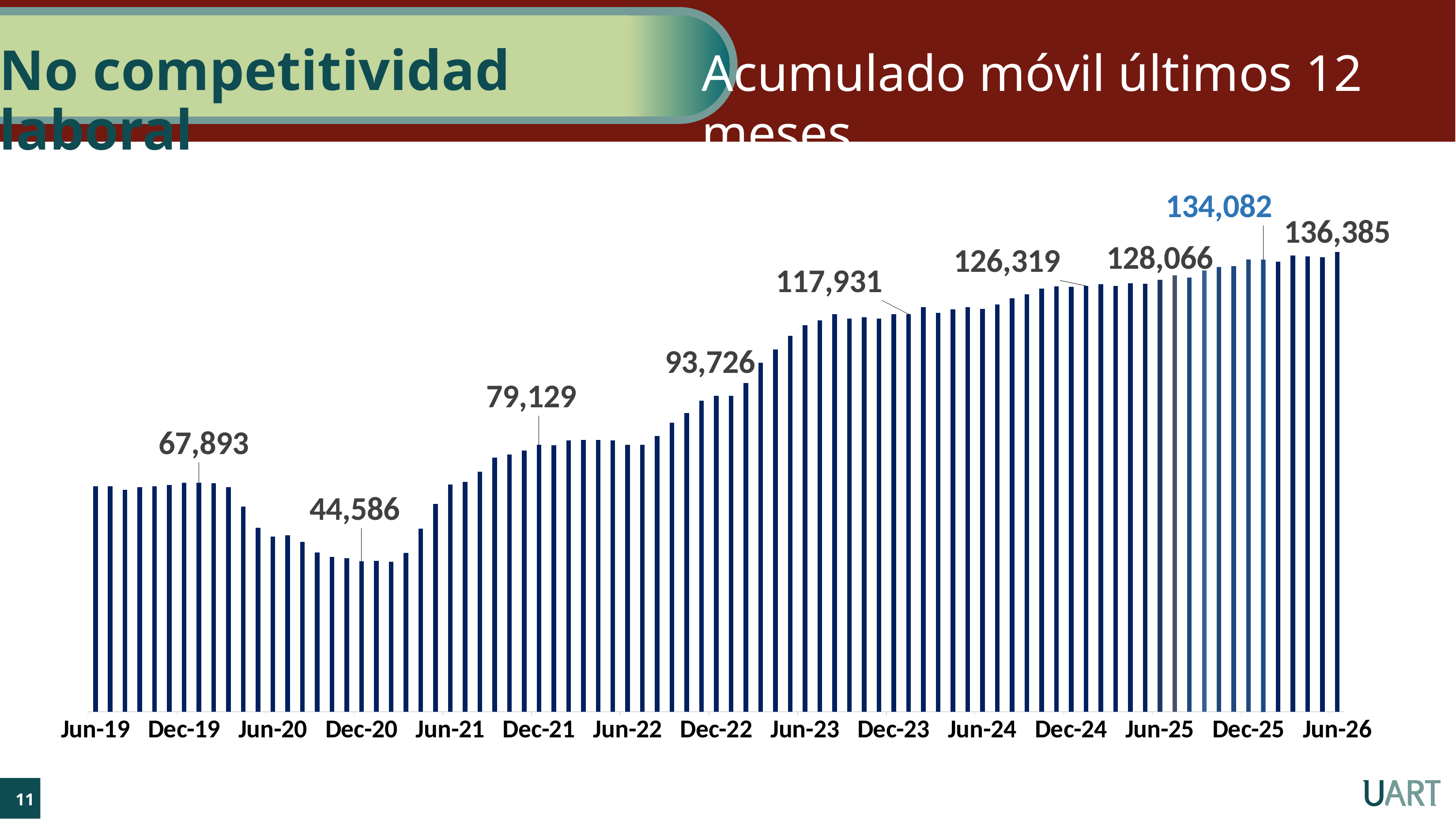
What is the title of the chart? Acumulado móvil últimos 12 meses What is the first label on the x axis? Jun-19 What is the difference between the labelled values 136,385 and 134,082? 2,303 What value is printed on the last bar (Jun-26)? 136,385 What kind of chart is shown on the slide? bar chart What value is printed in blue above the highlighted bar? 134,082 What is the highest value labelled on the chart? 136,385 What is the difference between the labelled values 79,129 and 44,586? 34,543 Do the bars generally rise or fall from Jun-21 to Jun-26? rise Which labelled value is larger, 128,066 or 126,319? 128,066 How many data labels are printed on the chart? 9 What is the lowest value labelled on the chart? 44,586